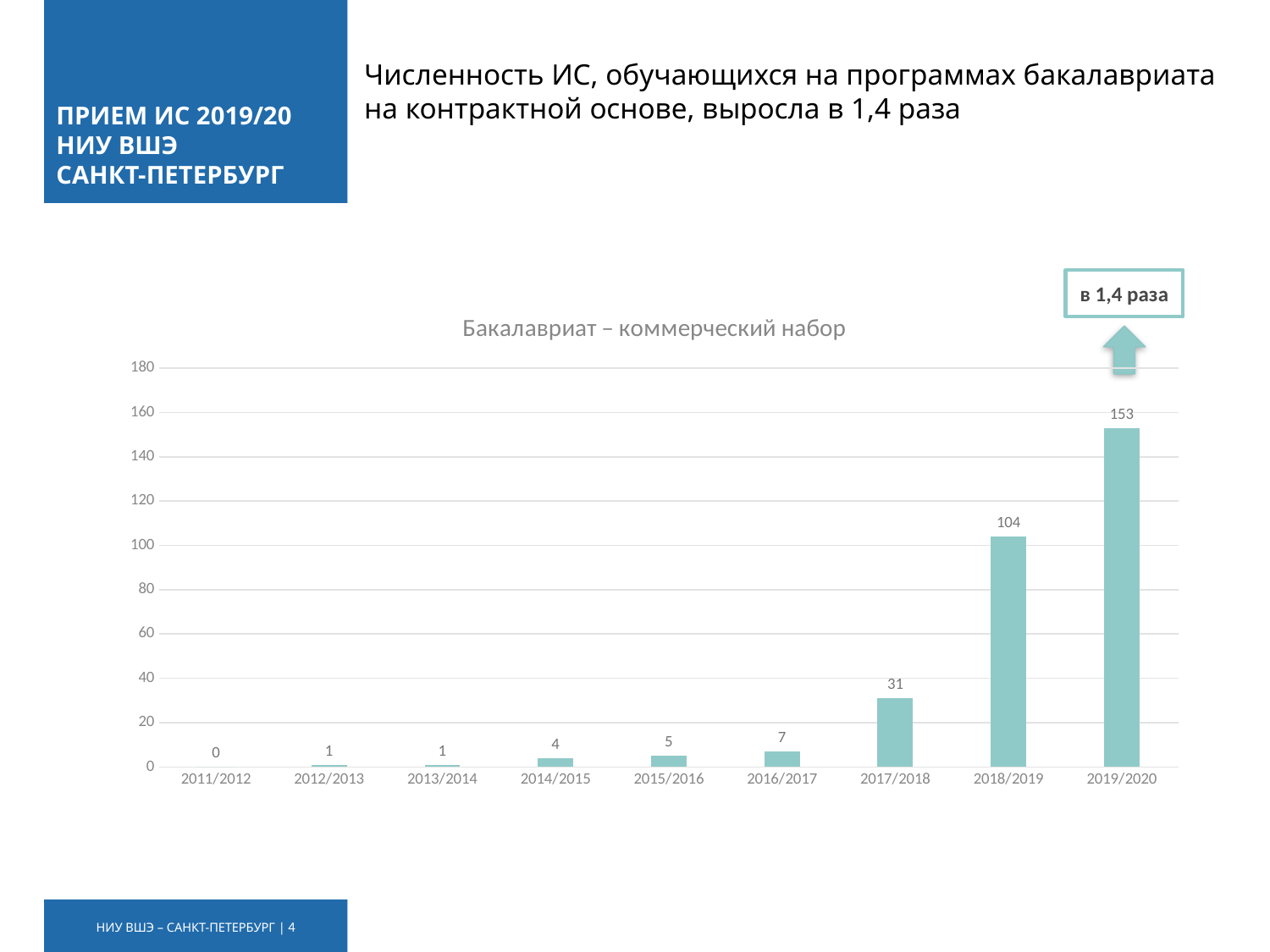
Do the values rise or fall from 2011/2012 to 2019/2020? rise Which year has the highest value? 2019/2020 What is the value for 2017/2018? 31 What is the value for 2014/2015? 4 How many years are shown on the x axis? 9 Is the value for 2018/2019 greater or less than 100? greater Which year has the lowest value? 2011/2012 What is the difference between the values for 2019/2020 and 2018/2019? 49 Which is larger, the value for 2016/2017 or the value for 2017/2018? 2017/2018 What is the value for 2019/2020? 153 What kind of chart is this? bar chart What is the title of the chart? Бакалавриат – коммерческий набор